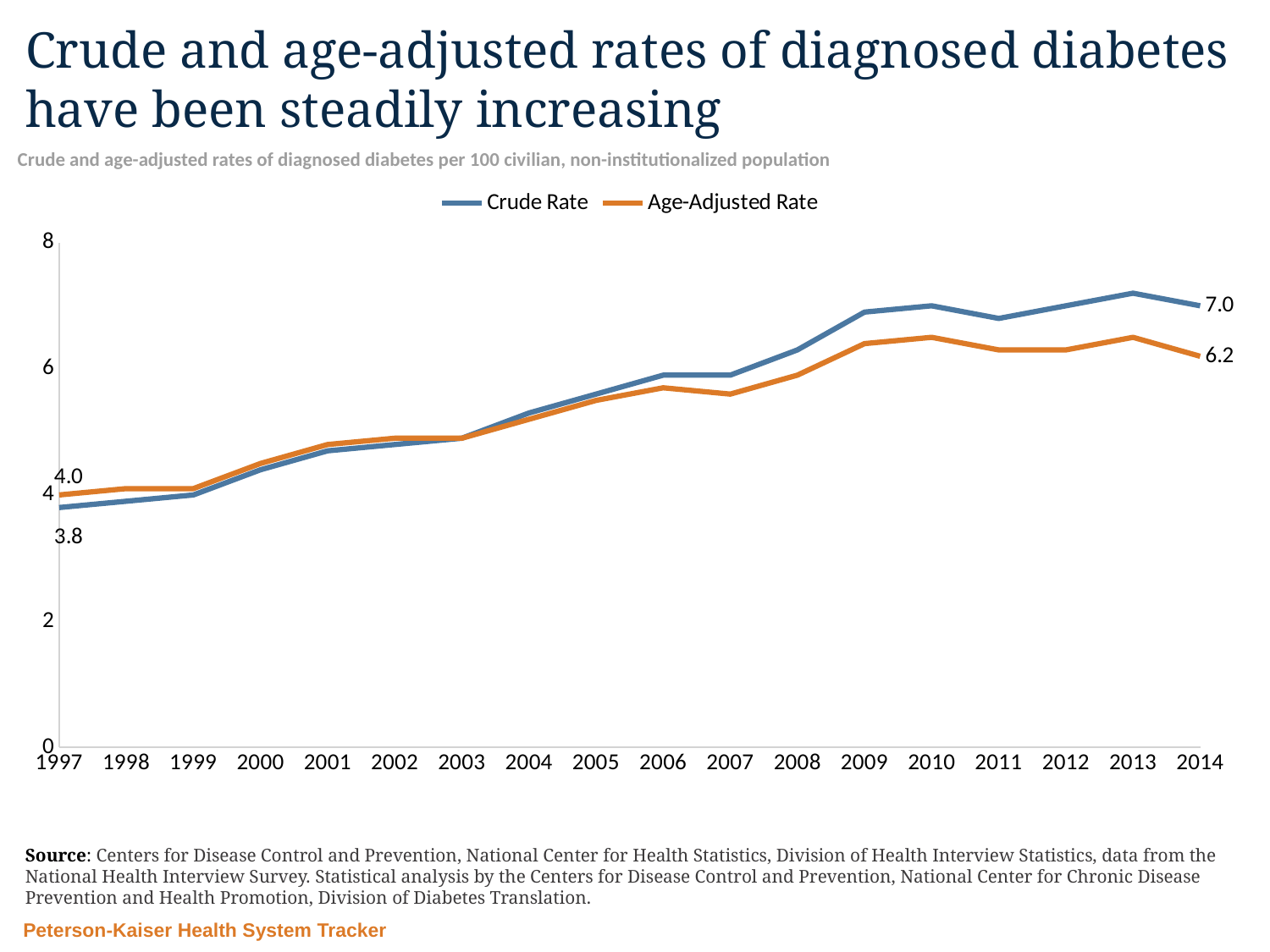
In 2014, which series has the higher value, Crude Rate or Age-Adjusted Rate? Crude Rate How many series does the legend list? 2 What was the Age-Adjusted Rate in 1997? 4.0 Do the rates generally rise or fall from 1997 to 2014? rise How many years are shown on the x axis? 18 What was the Crude Rate in 2014? 7.0 By how much did the Crude Rate increase from 1997 to 2014? 3.2 Is the Crude Rate in 2009 greater or less than 6? greater What is the difference between the Crude Rate and the Age-Adjusted Rate in 2014? 0.8 What was the Age-Adjusted Rate in 2014? 6.2 What was the Crude Rate in 1997? 3.8 What kind of chart is shown on the slide? line chart